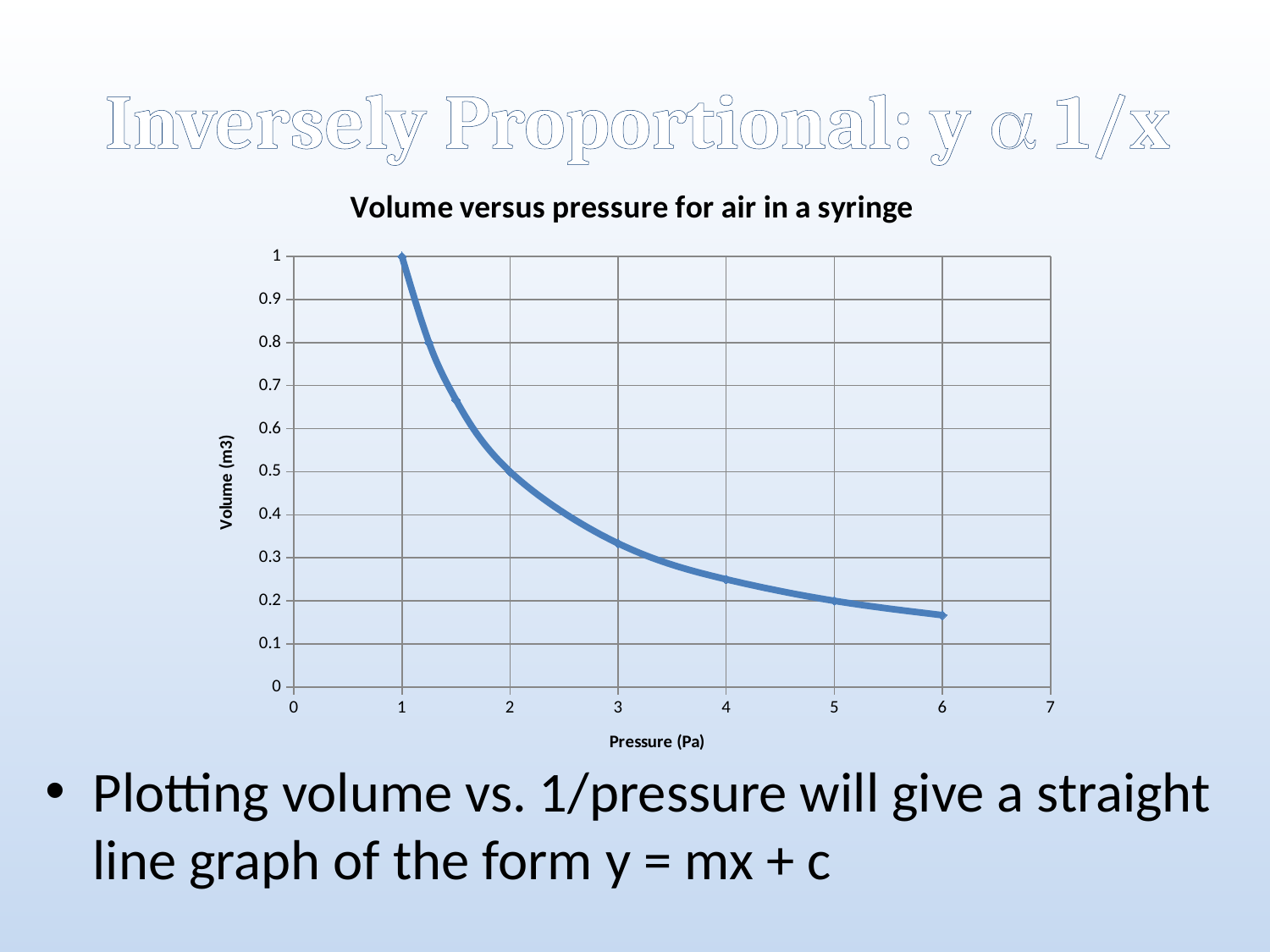
Is the volume at a pressure of 4 Pa greater or less than 0.2? greater What is the volume when the pressure is 1 Pa? 1 What is the title of the chart? Volume versus pressure for air in a syringe Does the volume rise or fall as pressure increases along the x axis? fall What is the volume when the pressure is 5 Pa? 0.2 What is the volume when the pressure is 2 Pa? 0.5 Is the volume at a pressure of 3 Pa greater or less than 0.4? less What kind of chart is shown on the slide? line chart What is the label of the x axis? Pressure (Pa) What is the difference between the volume at 1 Pa and the volume at 2 Pa? 0.5 Which pressure has the higher volume, 1 Pa or 6 Pa? 1 Pa Is the volume at a pressure of 6 Pa greater or less than 0.2? less